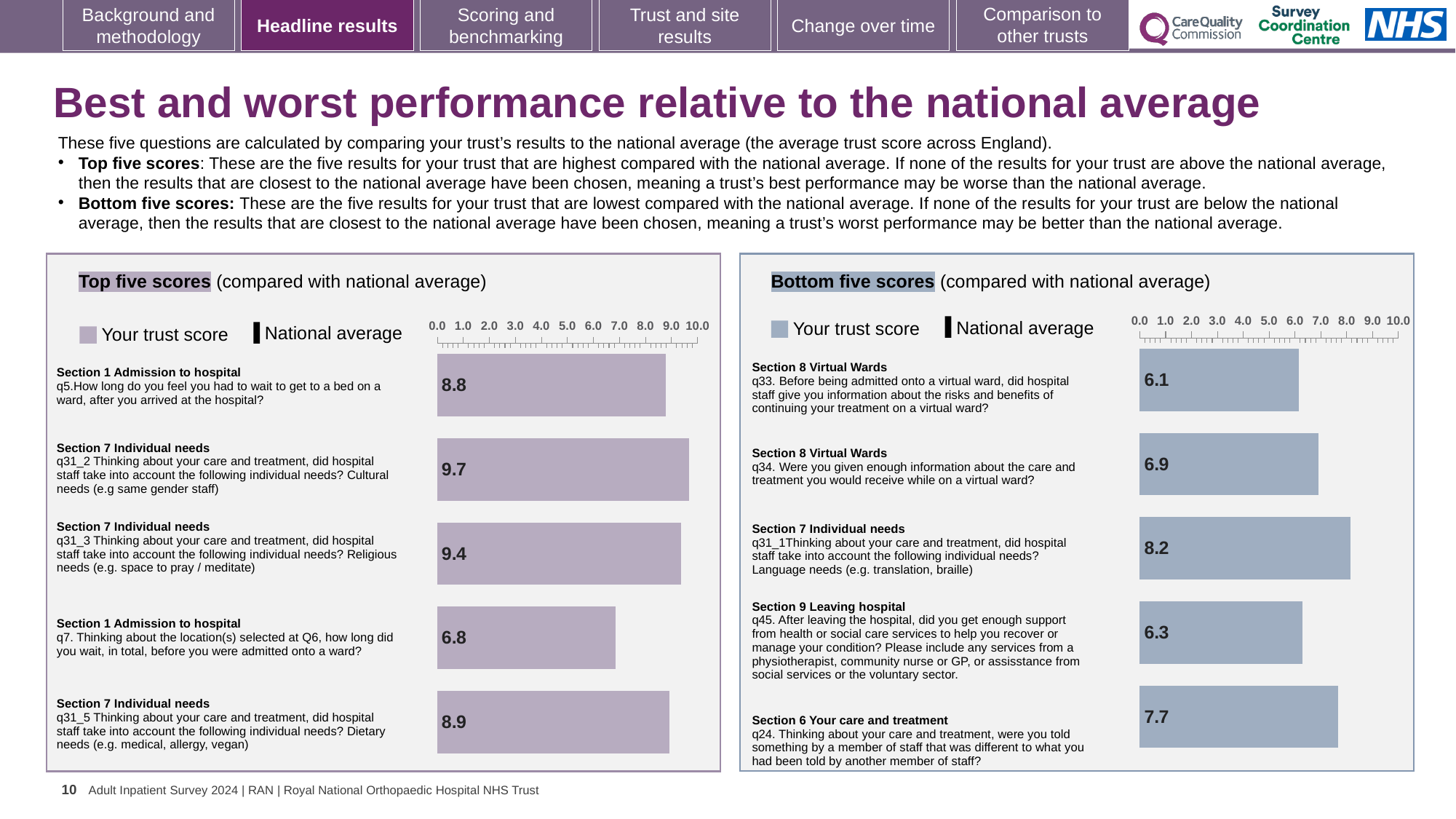
In the Bottom five scores chart, which question has the highest trust score? q31_1 (language needs) In the Bottom five scores chart, which question has the lowest trust score? q33 (virtual ward risks and benefits) In the Top five scores chart, which question has the highest trust score? q31_2 (cultural needs) In the Bottom five scores chart, what is the trust score for q33 (information about risks and benefits of a virtual ward)? 6.1 In the Top five scores chart, which has the larger trust score: q5 or q31_5? q31_5 In the Top five scores chart, what is the trust score for q7 (how long you waited before being admitted onto a ward)? 6.8 In the Top five scores chart, what is the difference between the trust scores for q31_2 and q7? 2.9 In the Bottom five scores chart, what is the trust score for q24 (told something different by another member of staff)? 7.7 How many questions are plotted in the Bottom five scores chart? 5 In the Top five scores chart, what is the trust score for q31_2 (cultural needs)? 9.7 What type of chart is used for the Top five scores? Bar chart In the Bottom five scores chart, what is the difference between the trust scores for q31_1 and q33? 2.1